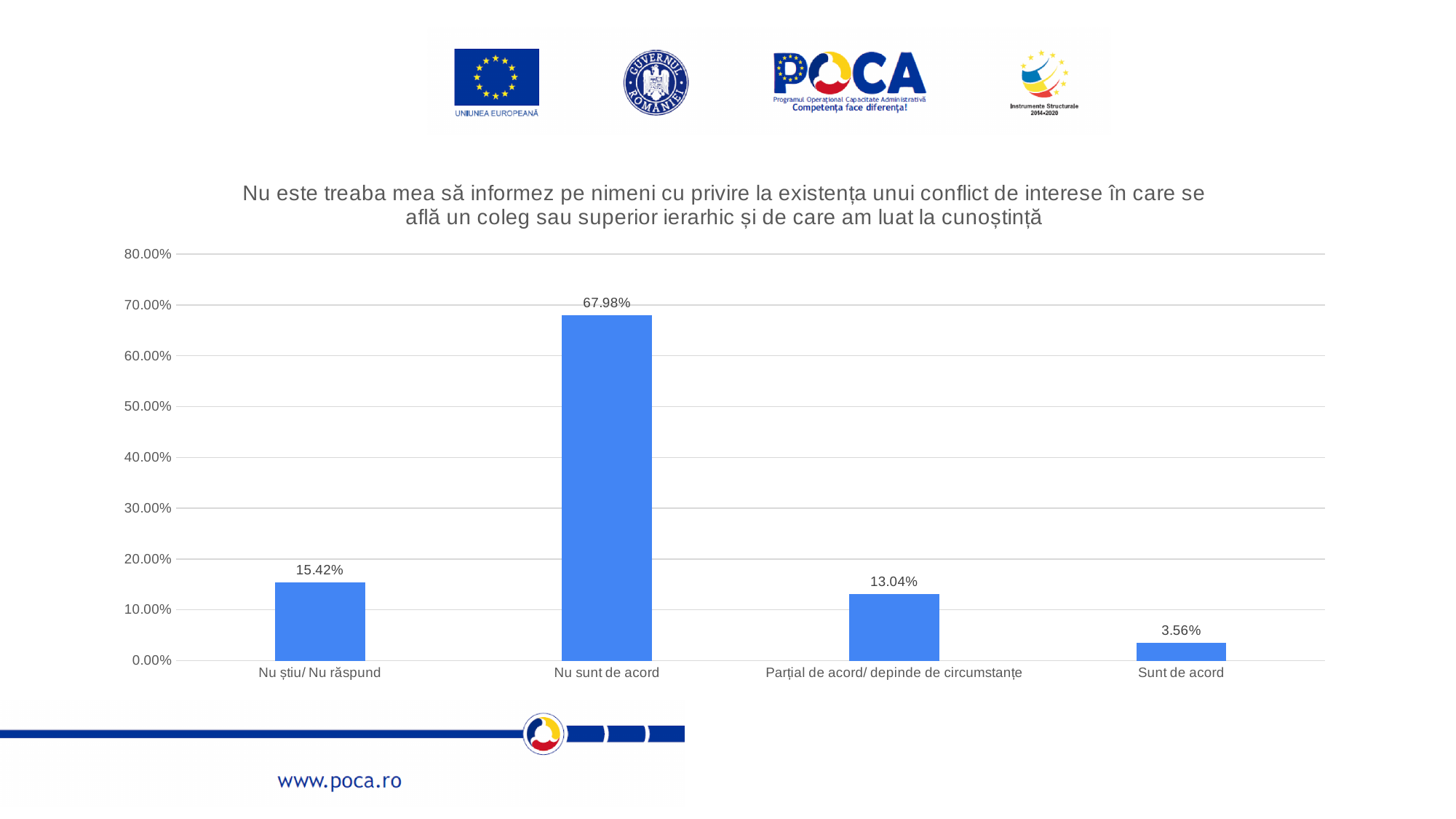
What kind of chart is shown on the slide? Bar chart What is the value for "Nu sunt de acord"? 67.98% Which category has the lowest value? Sunt de acord How many categories are shown on the x axis? 4 Is the value for "Nu sunt de acord" greater or less than 60.00%? greater What is the value for "Parțial de acord/ depinde de circumstanțe"? 13.04% What is the difference between the values for "Nu știu/ Nu răspund" and "Parțial de acord/ depinde de circumstanțe"? 2.38% Which is larger, the value for "Nu știu/ Nu răspund" or the value for "Parțial de acord/ depinde de circumstanțe"? Nu știu/ Nu răspund What is the difference between the values for "Nu sunt de acord" and "Sunt de acord"? 64.42% What is the value for "Nu știu/ Nu răspund"? 15.42% Which category has the highest value? Nu sunt de acord What is the value for "Sunt de acord"? 3.56%